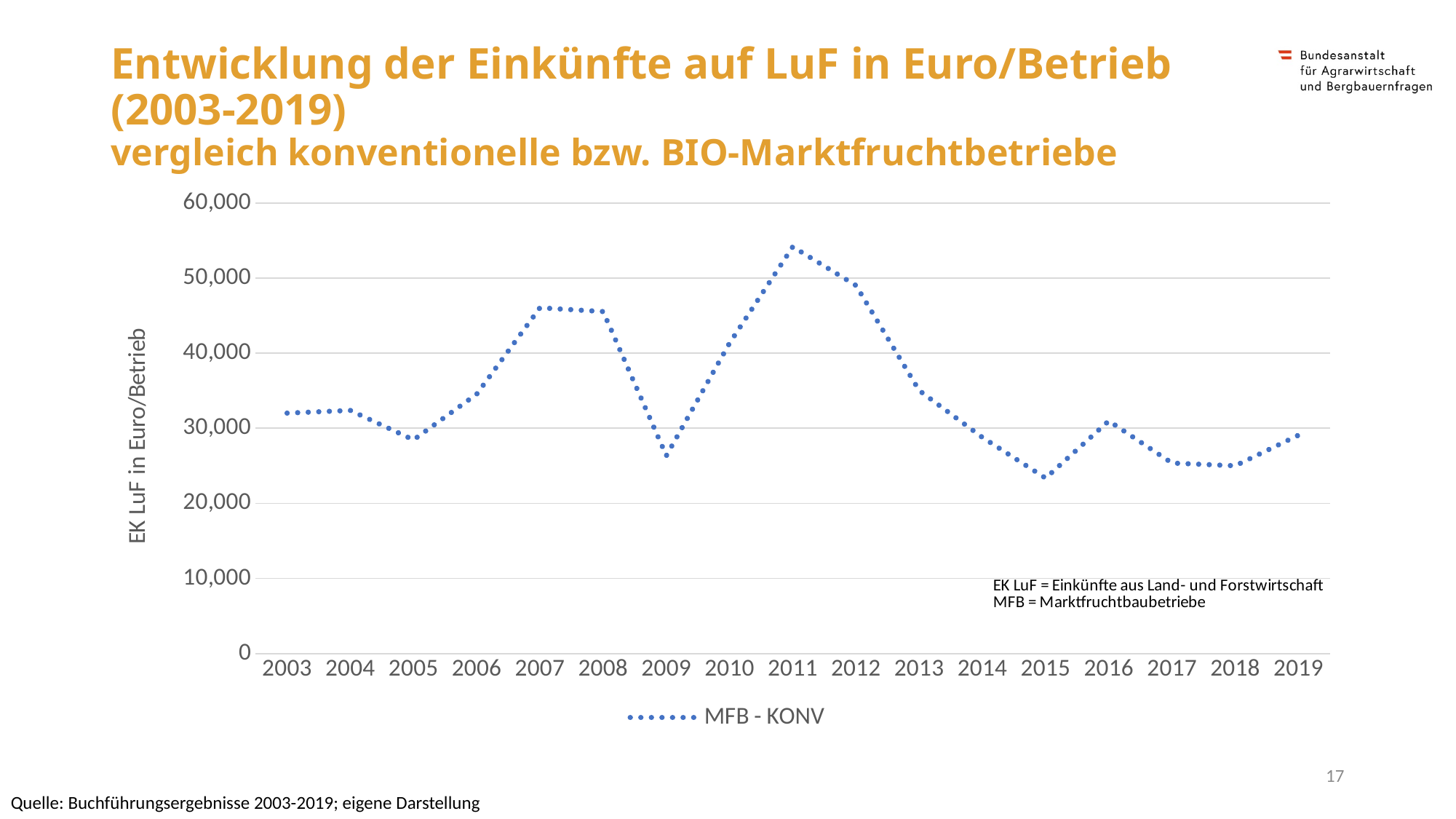
Is the value for MFB - KONV in 2007 greater or less than 40,000? greater Is the value for MFB - KONV in 2015 greater or less than 30,000? less How many series does the legend list? 1 Do the values for MFB - KONV rise or fall from 2011 to 2015? fall Is the value for MFB - KONV in 2009 greater or less than 30,000? less How many years are plotted along the x axis? 17 Which year has the larger value for MFB - KONV, 2007 or 2009? 2007 In which year is the value for MFB - KONV highest? 2011 What is the label on the y axis of the chart? EK LuF in Euro/Betrieb What kind of chart is shown on the slide? line chart In which year is the value for MFB - KONV lowest? 2015